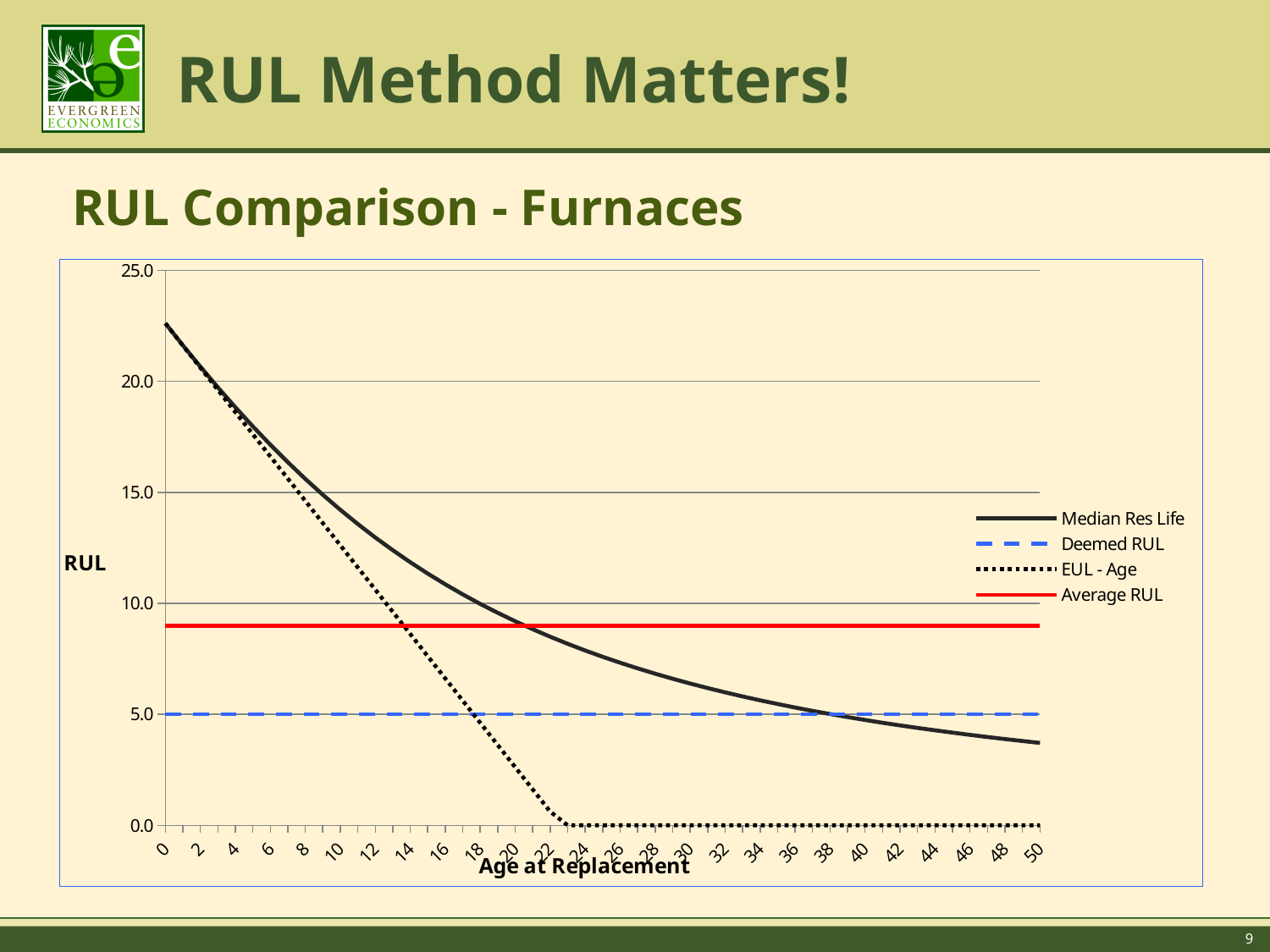
How many series does the legend list? 4 Is the Median Res Life value at age 50 greater or less than 5.0? less What kind of chart is shown on the slide? line chart What is the value of EUL - Age at an age at replacement of 30? 0.0 At an age at replacement of 16, which is larger: Median Res Life or EUL - Age? Median Res Life Is the EUL - Age value at age 4 greater or less than 15.0? greater Is the Median Res Life value at age 0 greater or less than 20.0? greater What is the value of the Deemed RUL line? 5.0 What are the four series listed in the legend? Median Res Life, Deemed RUL, EUL - Age, Average RUL What is the title of the x axis? Age at Replacement Does the Median Res Life line rise or fall as age at replacement increases? fall